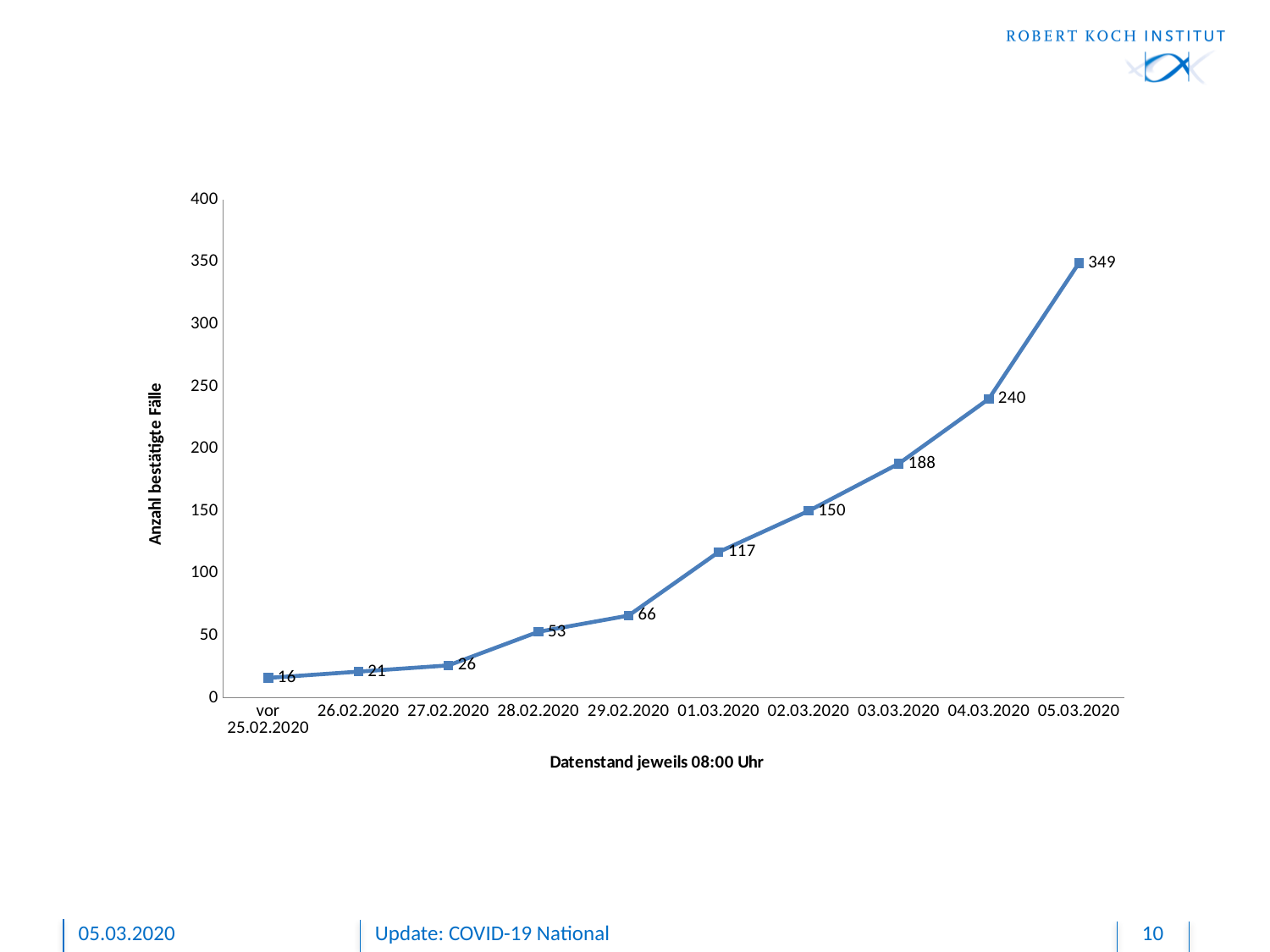
Which is larger, the value for 02.03.2020 or the value for 03.03.2020? 03.03.2020 What is the difference between the values for 29.02.2020 and 28.02.2020? 13 What is the number of confirmed cases (Anzahl bestätigte Fälle) on 01.03.2020? 117 What is the value plotted for 'vor 25.02.2020'? 16 What kind of chart is shown on the slide? line chart How many data points are plotted on the chart? 10 What is the value plotted for 05.03.2020? 349 Which category has the lowest value on the chart? vor 25.02.2020 What is the difference between the values for 05.03.2020 and 04.03.2020? 109 Is the value for 04.03.2020 greater or less than 200? greater Do the values rise or fall along the x axis from left to right? rise Which date has the highest number of confirmed cases? 05.03.2020